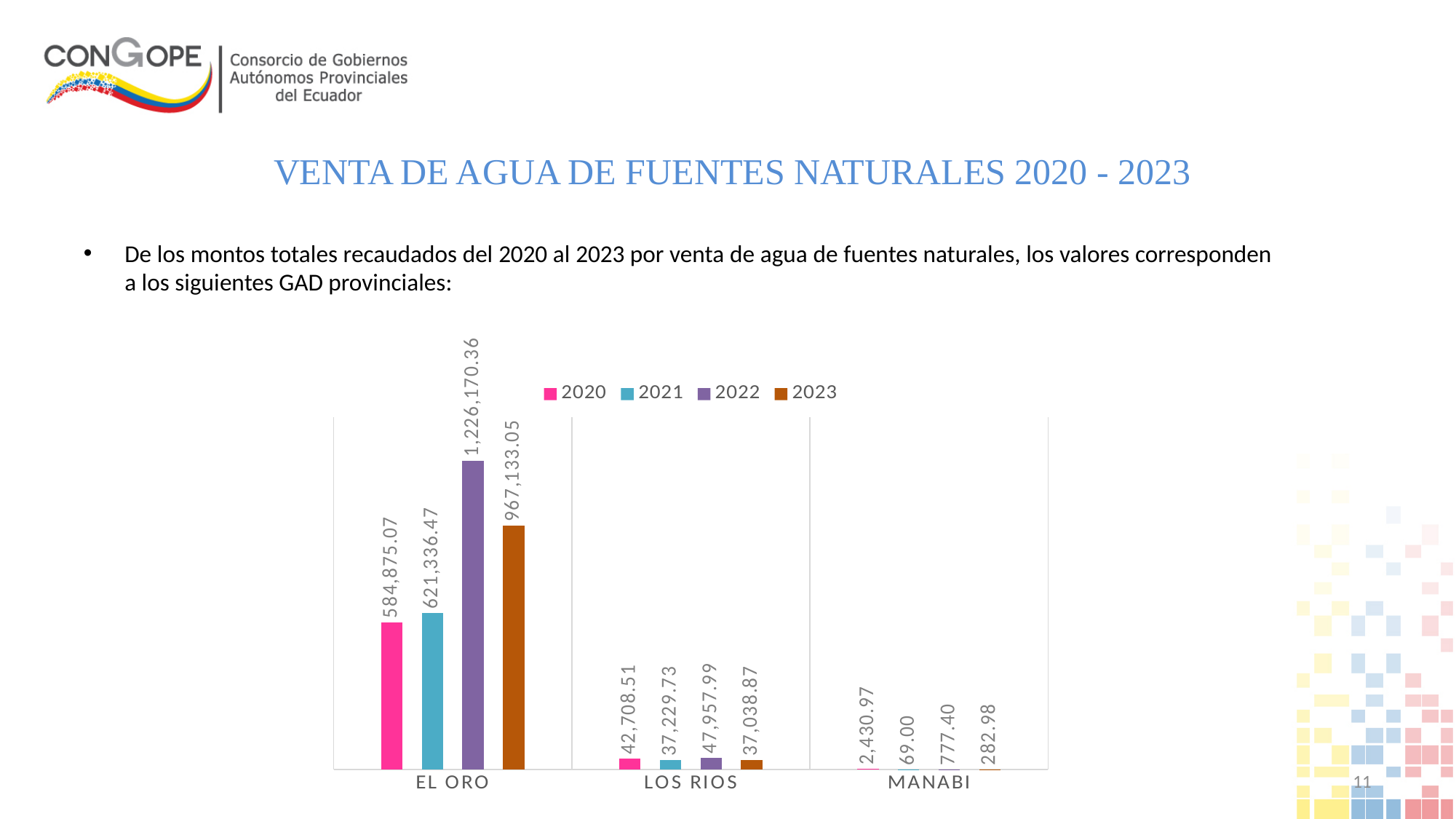
What is the value for EL ORO in 2023? 967,133.05 What is the value for EL ORO in 2022? 1,226,170.36 What is the difference between the 2022 and 2023 values for EL ORO? 259,037.31 What kind of chart is shown on the slide? Bar chart How many series does the legend list? 4 How many provinces (categories) are shown on the x axis? 3 Which year has the lowest value for MANABI? 2021 What is the value for MANABI in 2021? 69.00 Which is larger for LOS RIOS, the 2020 value or the 2021 value? 2020 What is the value for LOS RIOS in 2020? 42,708.51 Which year has the highest value for EL ORO? 2022 What is the difference between the 2022 and 2021 values for LOS RIOS? 10,728.26